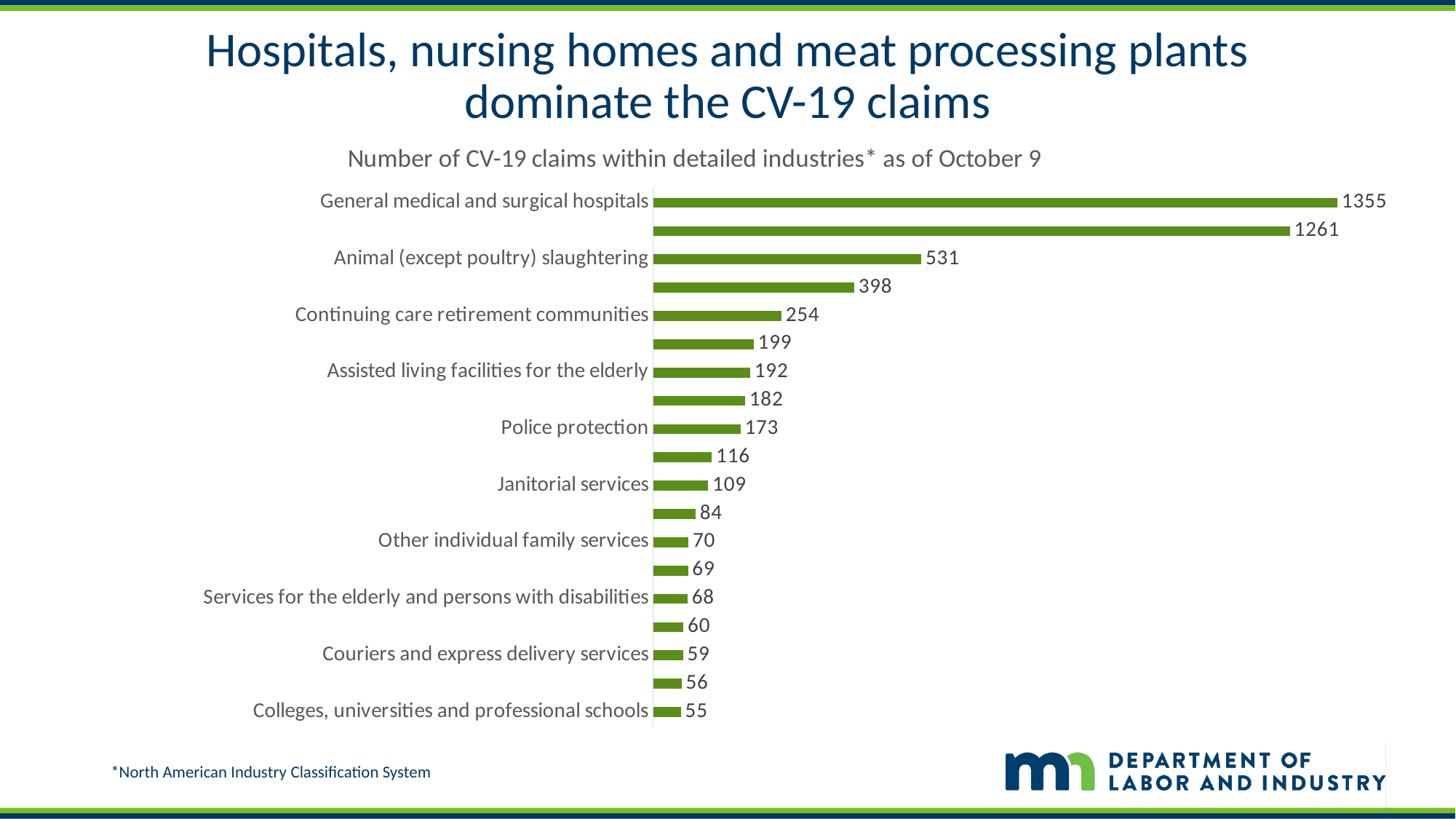
What is the number of CV-19 claims for Animal (except poultry) slaughtering? 531 Which labeled industry has the highest number of CV-19 claims? General medical and surgical hospitals What is the number of CV-19 claims for Couriers and express delivery services? 59 What is the number of CV-19 claims for General medical and surgical hospitals? 1355 What is the difference in CV-19 claims between General medical and surgical hospitals and Animal (except poultry) slaughtering? 824 Which has more CV-19 claims: Janitorial services or Assisted living facilities for the elderly? Assisted living facilities for the elderly What is the chart's subtitle above the bars? Number of CV-19 claims within detailed industries* as of October 9 What kind of chart is shown on the slide? Bar chart What is the number of CV-19 claims for Police protection? 173 How many bars are plotted in the chart? 19 Which labeled industry has the lowest number of CV-19 claims? Colleges, universities and professional schools What is the number of CV-19 claims for Continuing care retirement communities? 254